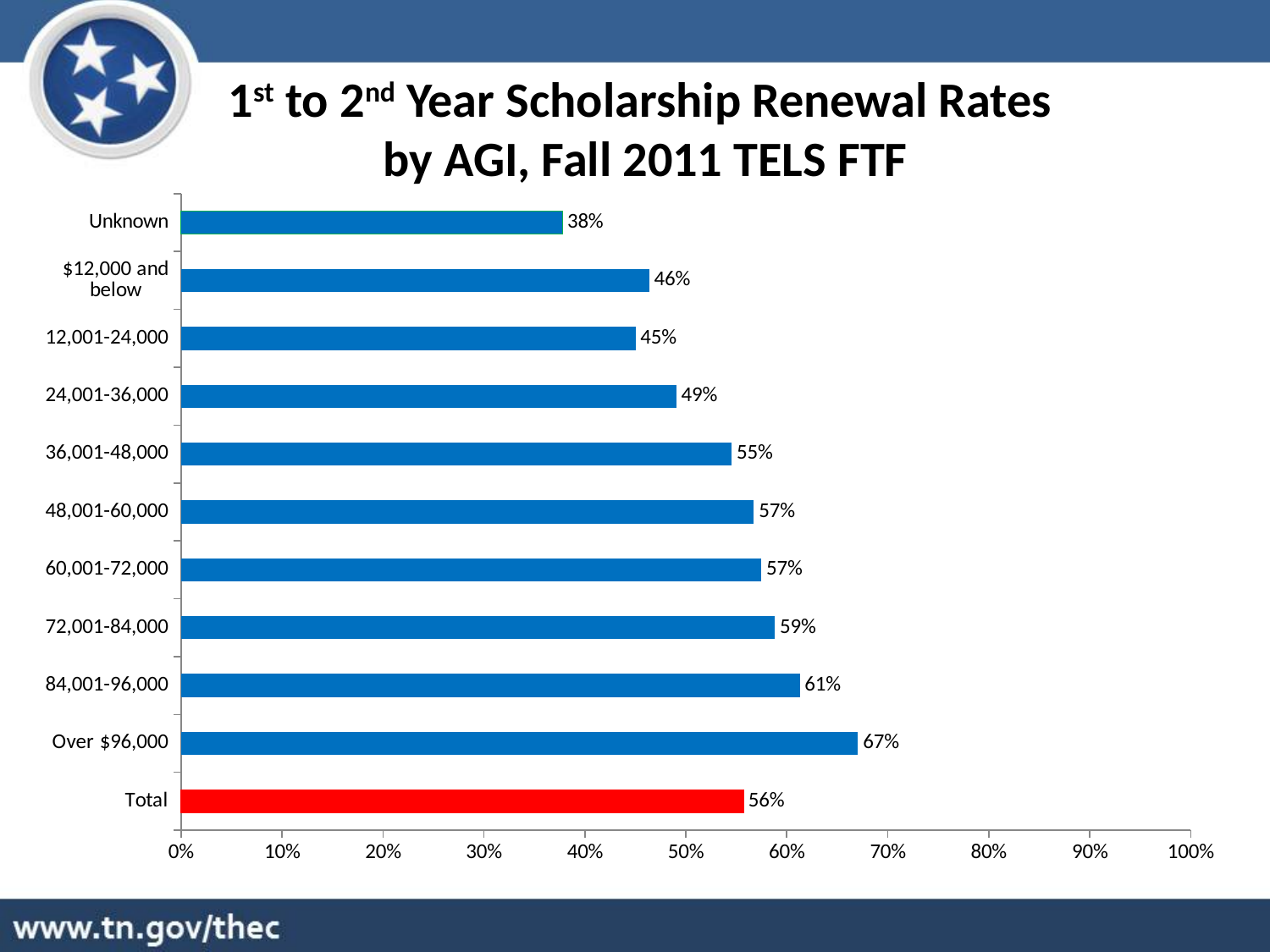
What is the Total renewal rate shown on the chart? 56% What kind of chart is shown on the slide? Bar chart Which category has the lowest renewal rate? Unknown Which has a higher renewal rate: 24,001-36,000 or 36,001-48,000? 36,001-48,000 What is the difference between the renewal rates for Over $96,000 and $12,000 and below? 21% Which AGI category has the highest renewal rate? Over $96,000 How many categories (bars) are shown on the chart? 11 Is the renewal rate for 84,001-96,000 greater or less than 50%? greater What is the renewal rate for the Over $96,000 AGI group? 67% What is the renewal rate for the 72,001-84,000 AGI group? 59% Which bar is coloured red rather than blue? Total What is the renewal rate for the Unknown AGI category? 38%